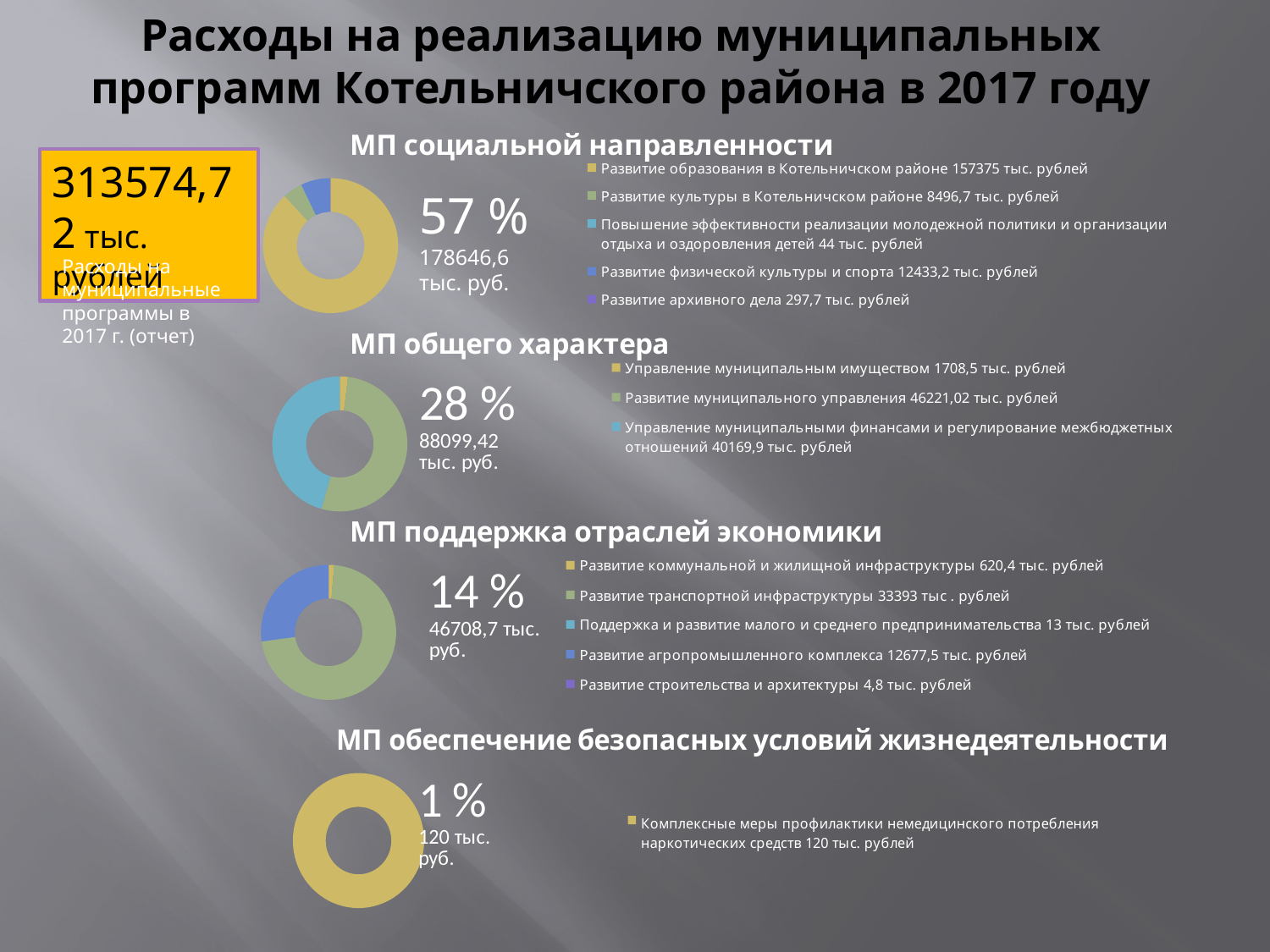
What kind of chart is used for "МП социальной направленности"? doughnut chart How many categories does the legend of the "МП обеспечение безопасных условий жизнедеятельности" chart list? 1 In the "МП поддержка отраслей экономики" chart, what is the value for "Развитие строительства и архитектуры"? 4,8 тыс. рублей In the "МП общего характера" chart, what is the difference between "Развитие муниципального управления" and "Управление муниципальными финансами и регулирование межбюджетных отношений"? 6051,12 тыс. рублей In the "МП общего характера" chart, which category has the highest value? Развитие муниципального управления In the "МП общего характера" chart, what is the value for "Развитие муниципального управления"? 46221,02 тыс. рублей What share of total expenditure does the "МП социальной направленности" chart show? 57 % In the "МП поддержка отраслей экономики" chart, which is larger: "Развитие транспортной инфраструктуры" or "Развитие агропромышленного комплекса"? Развитие транспортной инфраструктуры In the "МП социальной направленности" chart, what is the value for "Развитие образования в Котельничском районе"? 157375 тыс. рублей In the "МП социальной направленности" chart, how many categories does the legend list? 5 What total amount is shown next to the "МП поддержка отраслей экономики" chart? 46708,7 тыс. руб. In the "МП социальной направленности" chart, which category has the lowest value? Повышение эффективности реализации молодежной политики и организации отдыха и оздоровления детей